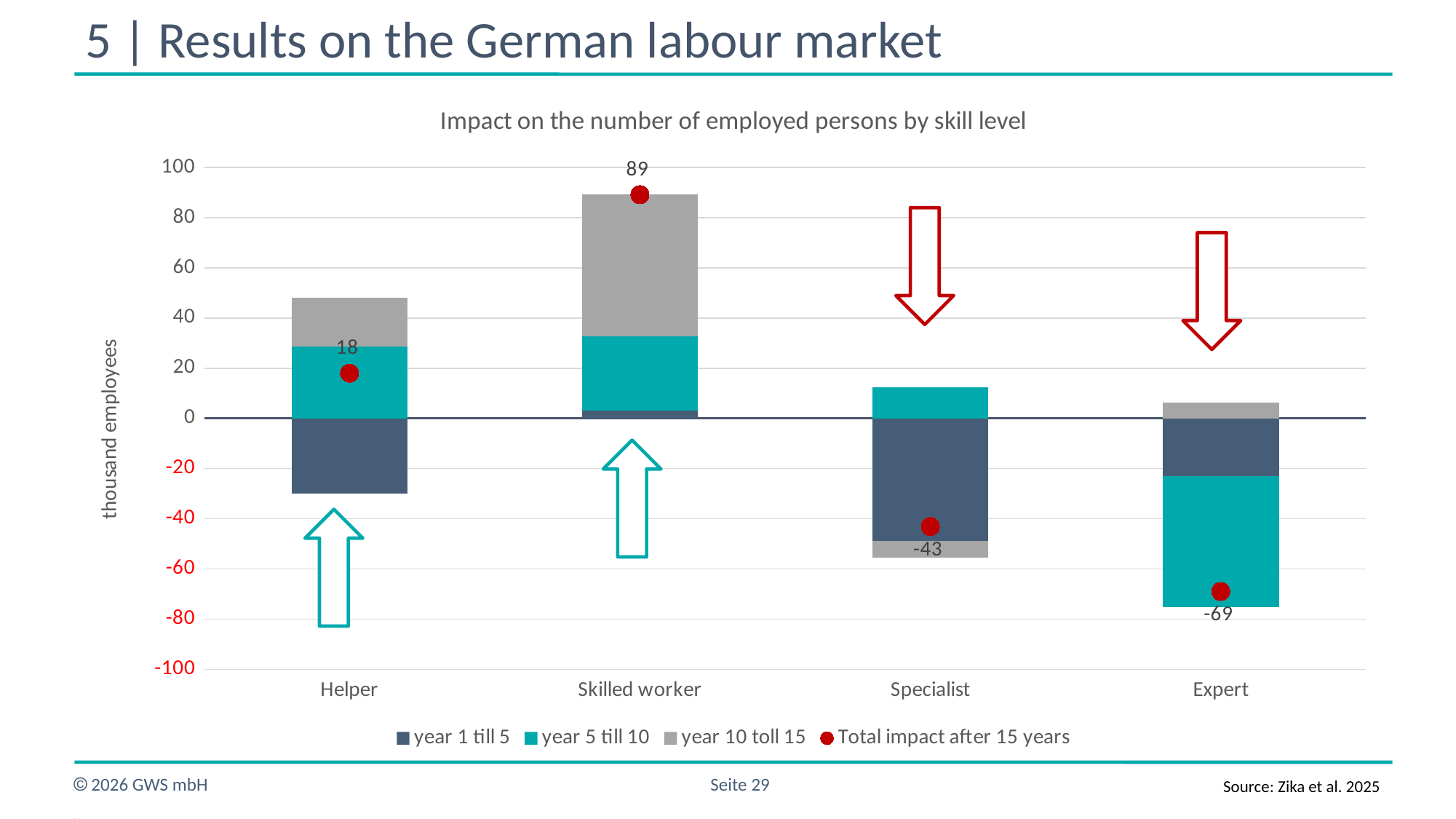
What is the Total impact after 15 years for Helper? 18 How many series does the legend list? 4 What is the label on the vertical axis? thousand employees How many skill level categories are shown on the x axis? 4 Which skill level has the lowest Total impact after 15 years? Expert Which skill level has the highest Total impact after 15 years? Skilled worker What is the Total impact after 15 years for Skilled worker? 89 Is the year 1 till 5 value for Helper greater or less than -20? less What is the difference between the Total impact after 15 years for Skilled worker and for Helper? 71 Which has a larger Total impact after 15 years, Helper or Specialist? Helper What is the Total impact after 15 years for Specialist? -43 What is the Total impact after 15 years for Expert? -69